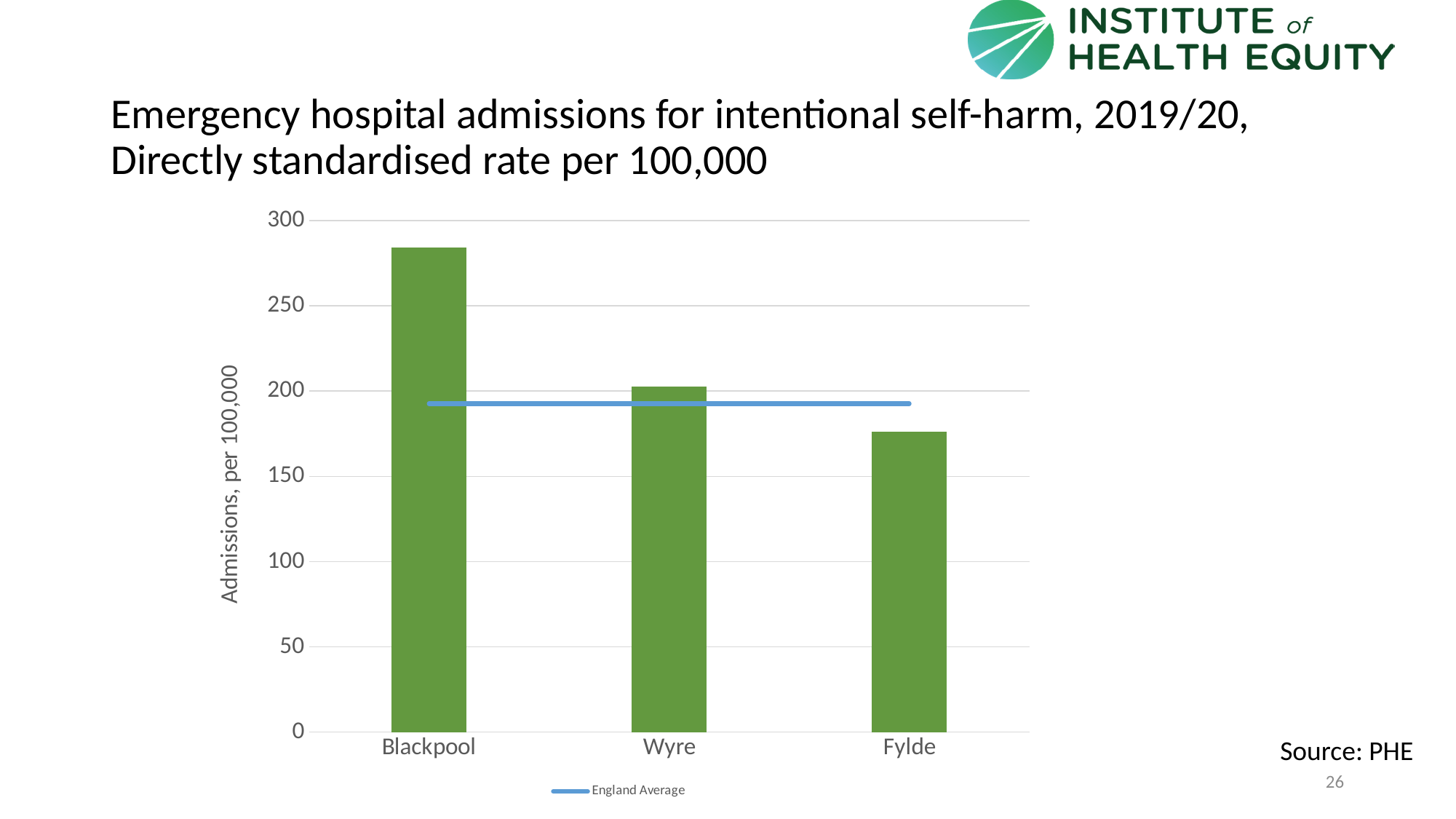
Which area has the lowest rate of emergency hospital admissions for intentional self-harm? Fylde Which area has the highest rate of emergency hospital admissions for intentional self-harm? Blackpool What is the label on the vertical axis of the chart? Admissions, per 100,000 Which has the larger value, Blackpool or Wyre? Blackpool What type of chart is shown on the slide? Bar chart Is the value for Wyre greater or less than 150? greater What does the horizontal blue line on the chart represent, according to the legend? England Average How many areas are shown as bars on the chart? 3 Is the value for Fylde greater or less than 200? less Do the bar values rise or fall from left to right across the x axis? Fall Which has the larger value, Wyre or Fylde? Wyre Is the value for Blackpool greater or less than 250? greater